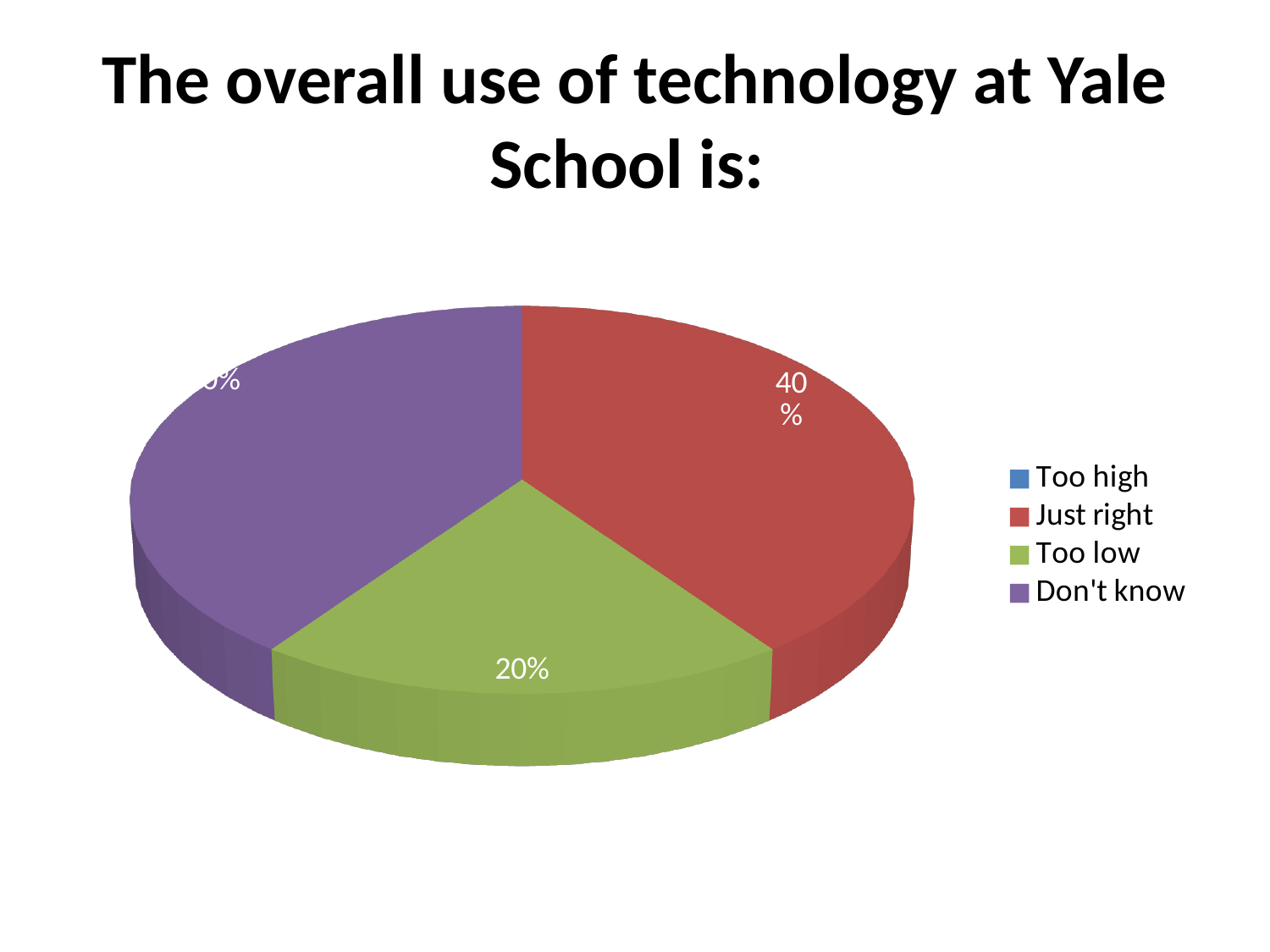
What colour represents "Just right" in the legend? Red Which is larger, the "Just right" slice or the "Too low" slice? Just right How many data series does the pie chart plot? 1 What is the title of the slide containing the pie chart? The overall use of technology at Yale School is: What share of the pie does the "Too low" slice represent? 20% What percentage of the pie is labelled for the "Too low" slice? 20% How many categories does the legend list? 4 By how many percentage points does the "Just right" slice exceed the "Too low" slice? 20 percentage points What kind of chart is shown on the slide? Pie chart What percentage of the pie is labelled for the "Just right" slice? 40%